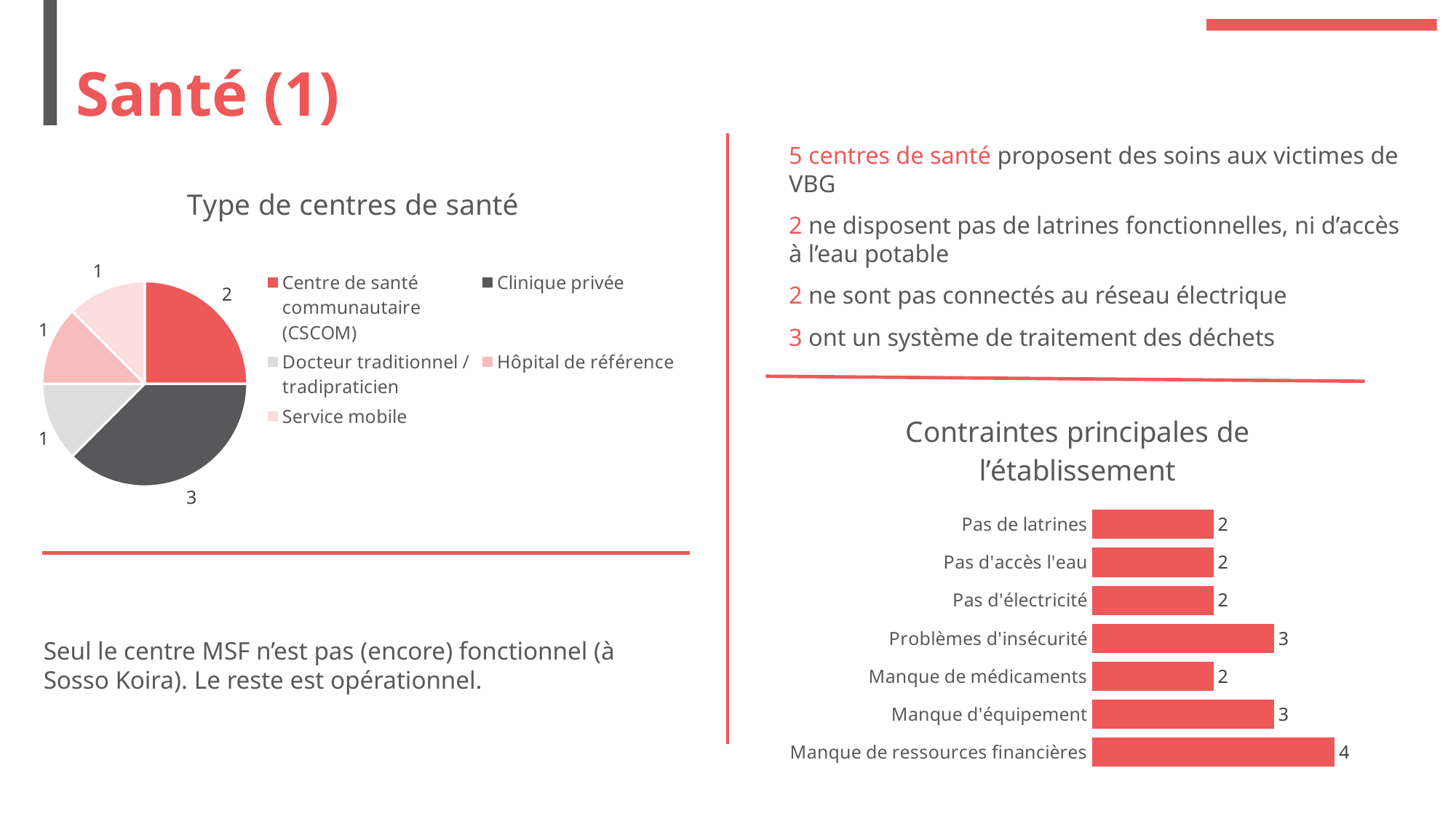
In the 'Contraintes principales de l'établissement' chart, how many categories are shown? 7 In the 'Type de centres de santé' chart, what is the value for Centre de santé communautaire (CSCOM)? 2 In the 'Type de centres de santé' chart, what kind of chart is it? pie chart In the 'Type de centres de santé' chart, what is the value for Clinique privée? 3 In the 'Contraintes principales de l'établissement' chart, which category has the highest value? Manque de ressources financières In the 'Contraintes principales de l'établissement' chart, what is the difference between Manque de ressources financières and Pas de latrines? 2 In the 'Contraintes principales de l'établissement' chart, what is the value for Manque de ressources financières? 4 In the 'Type de centres de santé' chart, how many categories does the legend list? 5 In the 'Contraintes principales de l'établissement' chart, which is larger: Problèmes d'insécurité or Manque de médicaments? Problèmes d'insécurité In the 'Type de centres de santé' chart, what share of the pie does Centre de santé communautaire (CSCOM) represent? 25% In the 'Type de centres de santé' chart, which category has the largest slice? Clinique privée In the 'Contraintes principales de l'établissement' chart, what kind of chart is it? bar chart